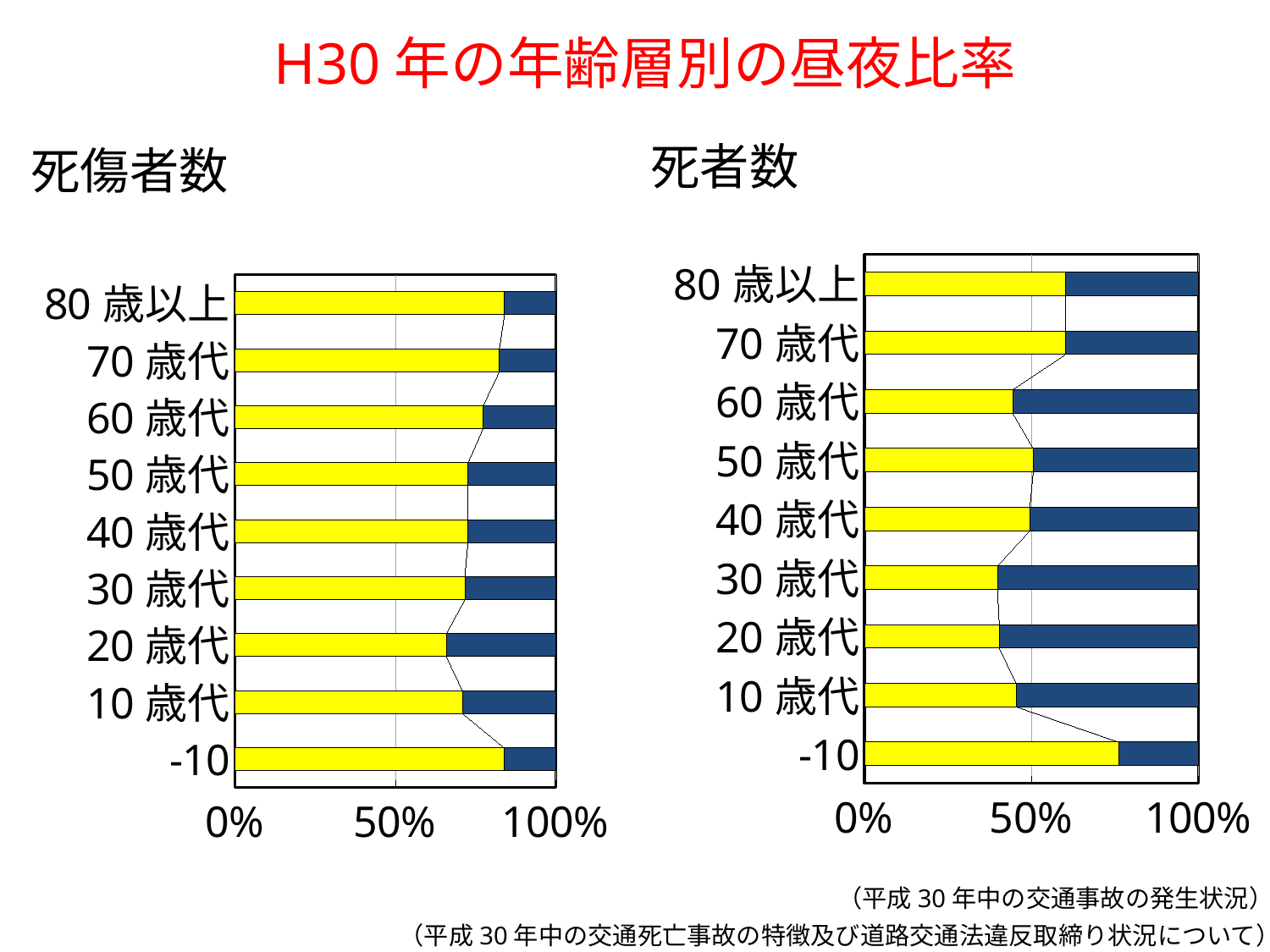
In the 死者数 chart on the right, is the yellow segment for 60歳代 greater or less than 50%? less In the 死者数 chart on the right, is the yellow segment for -10 greater or less than 50%? greater In the 死者数 chart on the right, which age category has the largest yellow segment? -10 What kind of chart is the 死傷者数 chart on the left? Stacked bar chart In the 死傷者数 chart on the left, which has the larger yellow segment, 80歳以上 or 20歳代? 80歳以上 How many age categories are shown in the 死傷者数 chart on the left? 9 In the 死傷者数 chart on the left, which age category has the smallest yellow segment? 20歳代 What kind of chart is the 死者数 chart on the right? Stacked bar chart In the 死傷者数 chart on the left, is the yellow segment for 20歳代 greater or less than 50%? greater What is the title of the slide above the two charts? H30年の年齢層別の昼夜比率 How many age categories are shown in the 死者数 chart on the right? 9